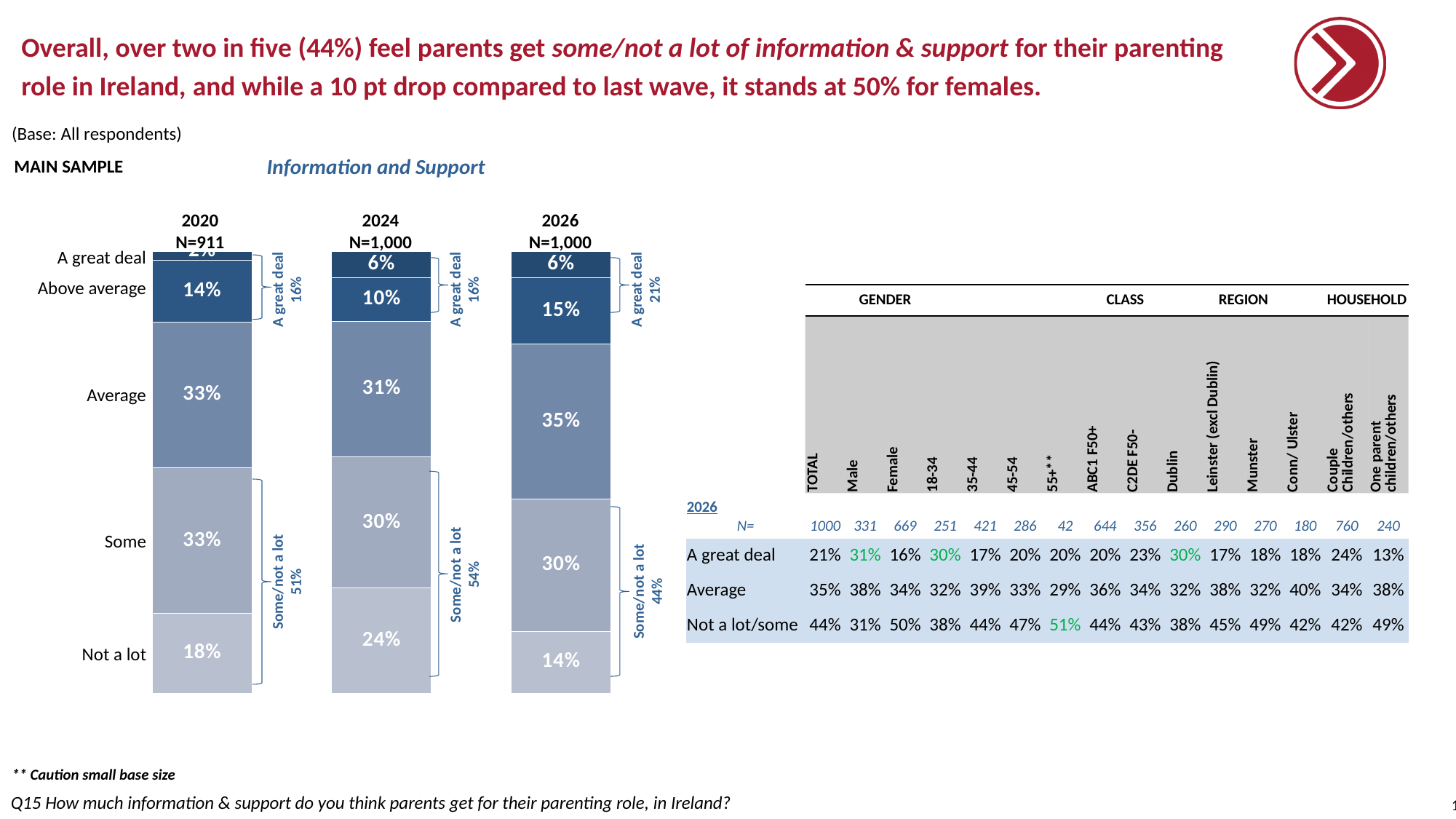
In the Information and Support chart, is the 'Average' value larger in 2024 or 2026? 2026 In the Information and Support chart, what is the combined 'Some/not a lot' figure shown for 2026? 44% In the Information and Support chart, which year has the highest 'Some/not a lot' combined figure? 2024 In the Information and Support chart, what is the difference between the 'Not a lot' values for 2024 and 2026? 10 percentage points In the Information and Support chart, what is the value for 'Average' in 2026? 35% In the Information and Support chart, which year has the lowest 'Not a lot' value? 2026 How many bars (years) are shown in the Information and Support chart? 3 In the Information and Support chart, what is the value for 'Above average' in 2020? 14% In the Information and Support chart, what is the combined 'A great deal' figure shown for 2026? 21% What type of chart is shown under 'Information and Support'? stacked bar chart In the Information and Support chart, what is the value for 'Not a lot' in 2024? 24% What is the sample size (N) shown for the 2020 bar in the Information and Support chart? N=911